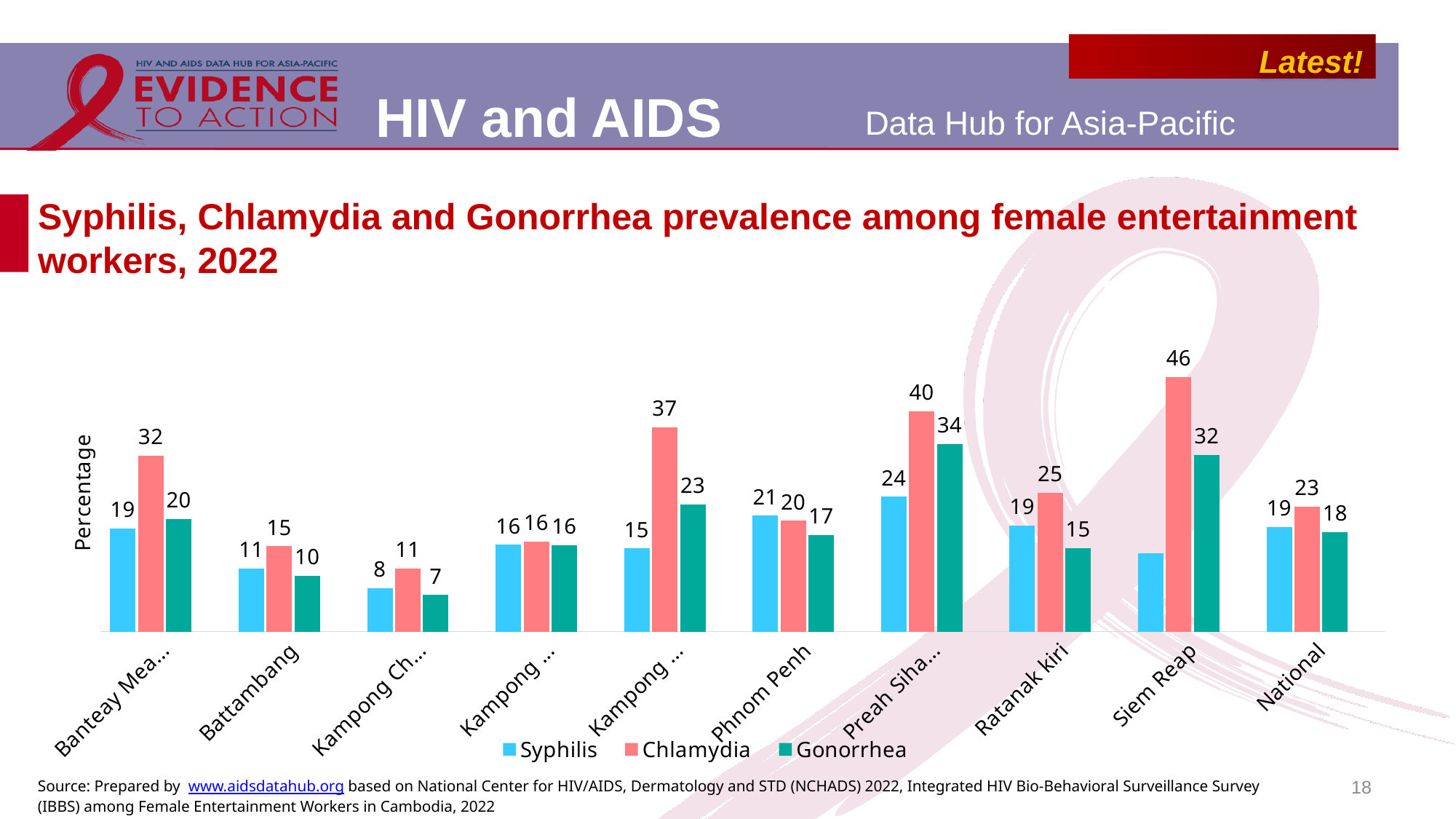
Which category has the highest Chlamydia prevalence? Siem Reap How many categories are shown on the x axis? 10 What is the Chlamydia prevalence for Siem Reap? 46 What is the label of the vertical axis? Percentage Which is larger for Battambang, the Chlamydia prevalence or the Gonorrhea prevalence? Chlamydia Which category has the lowest Gonorrhea prevalence? Kampong Ch... What is the National Chlamydia prevalence? 23 What is the Gonorrhea prevalence for Ratanak kiri? 15 What is the Syphilis prevalence for Phnom Penh? 21 How many series does the legend list? 3 What kind of chart is shown on the slide? Bar chart